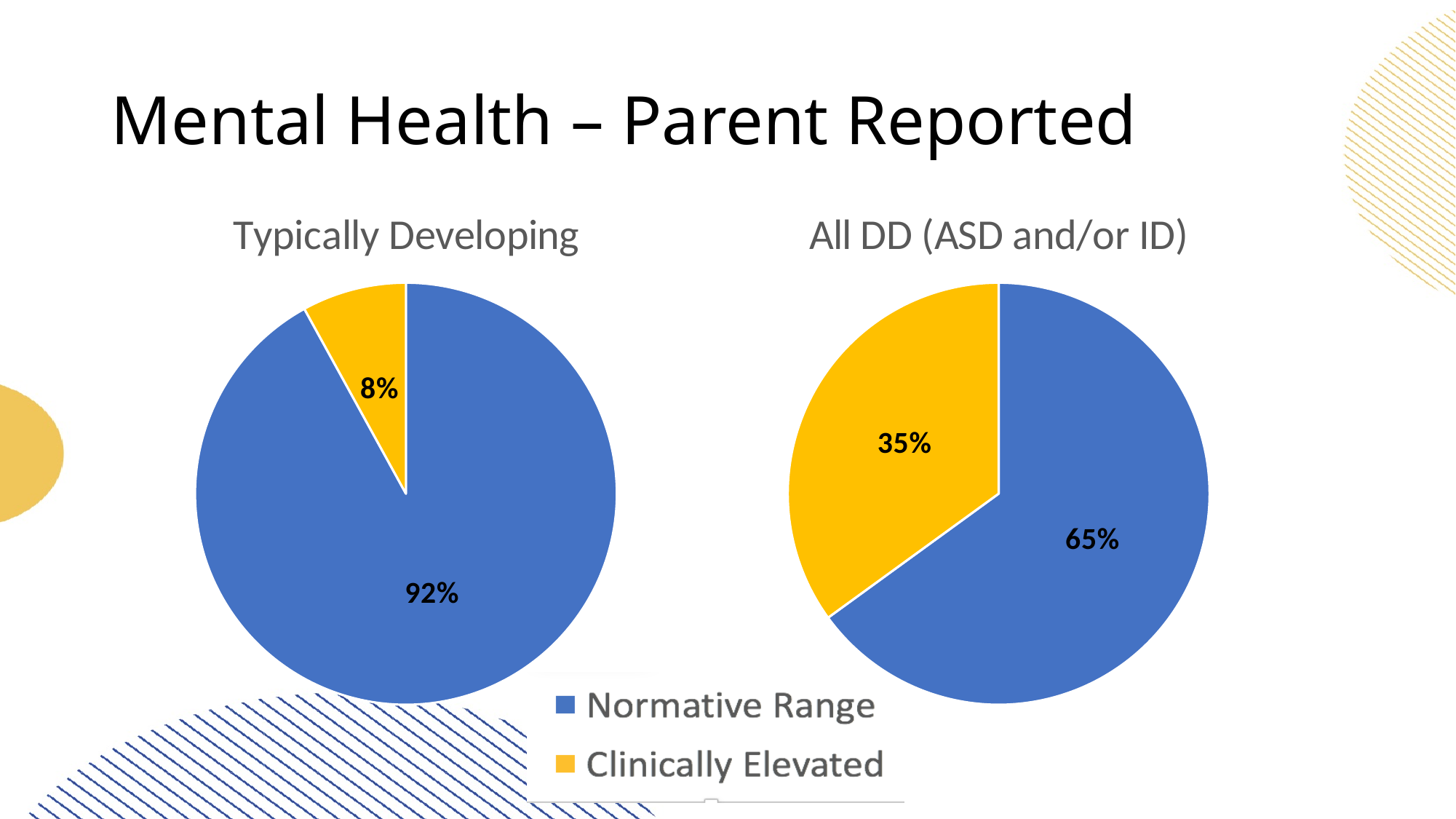
What type of chart is used for 'Typically Developing'? Pie chart How many entries does the legend list? 2 In the 'All DD (ASD and/or ID)' pie chart, what percentage is Clinically Elevated? 35% What colour represents Clinically Elevated in the pie charts? Yellow In the 'Typically Developing' pie chart, what percentage is in the Normative Range? 92% Which chart has the larger Clinically Elevated share, 'Typically Developing' or 'All DD (ASD and/or ID)'? All DD (ASD and/or ID) What is the difference between the Clinically Elevated share in the 'All DD (ASD and/or ID)' chart and the Clinically Elevated share in the 'Typically Developing' chart? 27% In the 'Typically Developing' pie chart, what percentage is Clinically Elevated? 8% In the 'All DD (ASD and/or ID)' pie chart, what percentage is in the Normative Range? 65% In the 'Typically Developing' pie chart, which category has the smallest share? Clinically Elevated In the 'All DD (ASD and/or ID)' pie chart, which category has the largest share? Normative Range How many slices does the 'All DD (ASD and/or ID)' pie chart have? 2